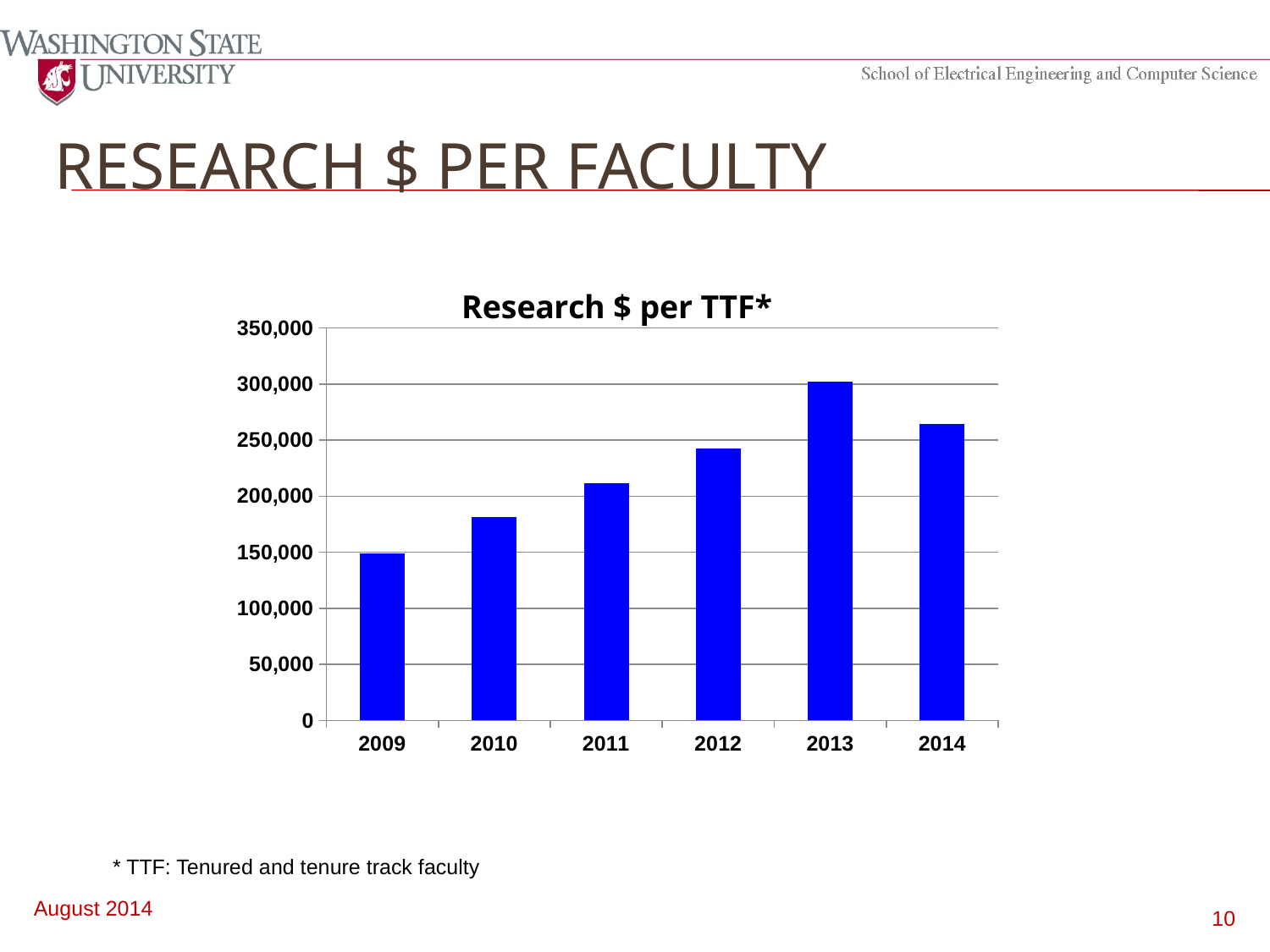
Is the value for 2010 greater or less than 200,000? less How many years are shown on the x axis of the chart? 6 Which year has a higher value, 2013 or 2014? 2013 What kind of chart is shown on the slide? Bar chart Is the value for 2014 greater or less than 250,000? greater Which year has the lowest research $ per TTF? 2009 Is the value for 2011 greater or less than 200,000? greater How do the values change from 2009 to 2013? They rise each year Which year has a higher value, 2010 or 2012? 2012 What is the title of the chart? Research $ per TTF* Which year has the highest research $ per TTF? 2013